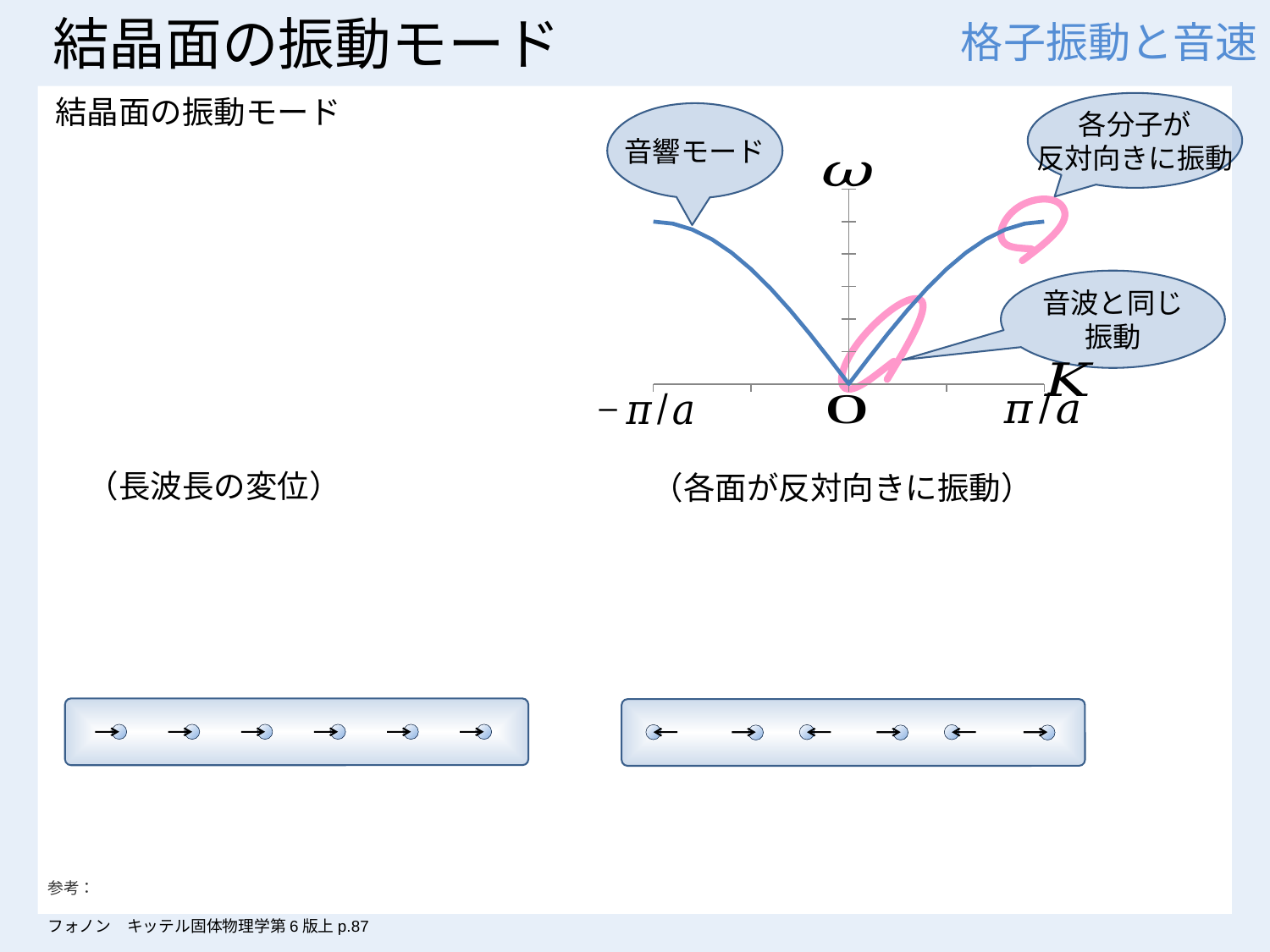
How many labelled tick positions are shown on the horizontal axis? 3 Is the value of the curve larger at K = -π/a or at K = O? -π/a Does the curve rise or fall as K goes from -π/a to O? fall How many curves are plotted on the chart? 1 Is the value of the curve larger at K = π/a or at K = O? π/a What is the label on the vertical axis of the chart? ω Does the curve rise or fall as K goes from O to π/a? rise What is the label on the horizontal axis of the chart? K What kind of chart is shown on the slide? line chart At which horizontal-axis label does the curve reach its lowest value? O